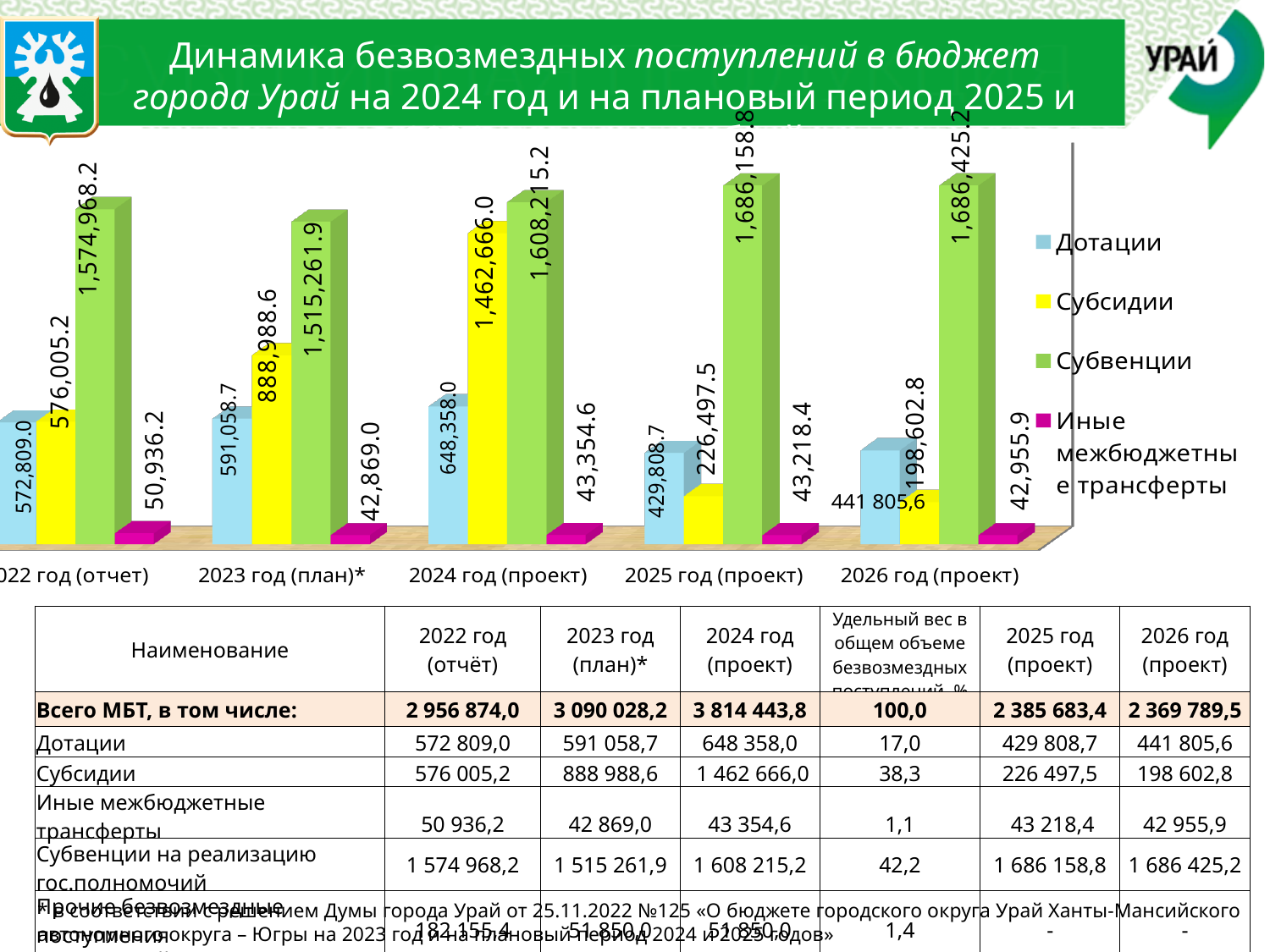
In which year is the value of Субсидии the lowest? 2026 год (проект) What is the value of Субсидии for 2023 год (план)*? 888,988.6 What is the value of Дотации for 2025 год (проект)? 429,808.7 In which year is the value of Дотации the highest? 2024 год (проект) In which year is the value of Субсидии the highest? 2024 год (проект) What is the value of Субвенции for 2024 год (проект)? 1,608,215.2 What kind of chart is shown on the slide? Bar chart What is the difference between the Субсидии values for 2024 год (проект) and 2023 год (план)*? 573,677.4 For 2025 год (проект), which is larger: Дотации or Субсидии? Дотации How many year categories are shown on the x axis of the chart? 5 How many series does the chart legend list? 4 What is the value of Иные межбюджетные трансферты for 2022 год (отчет)? 50,936.2